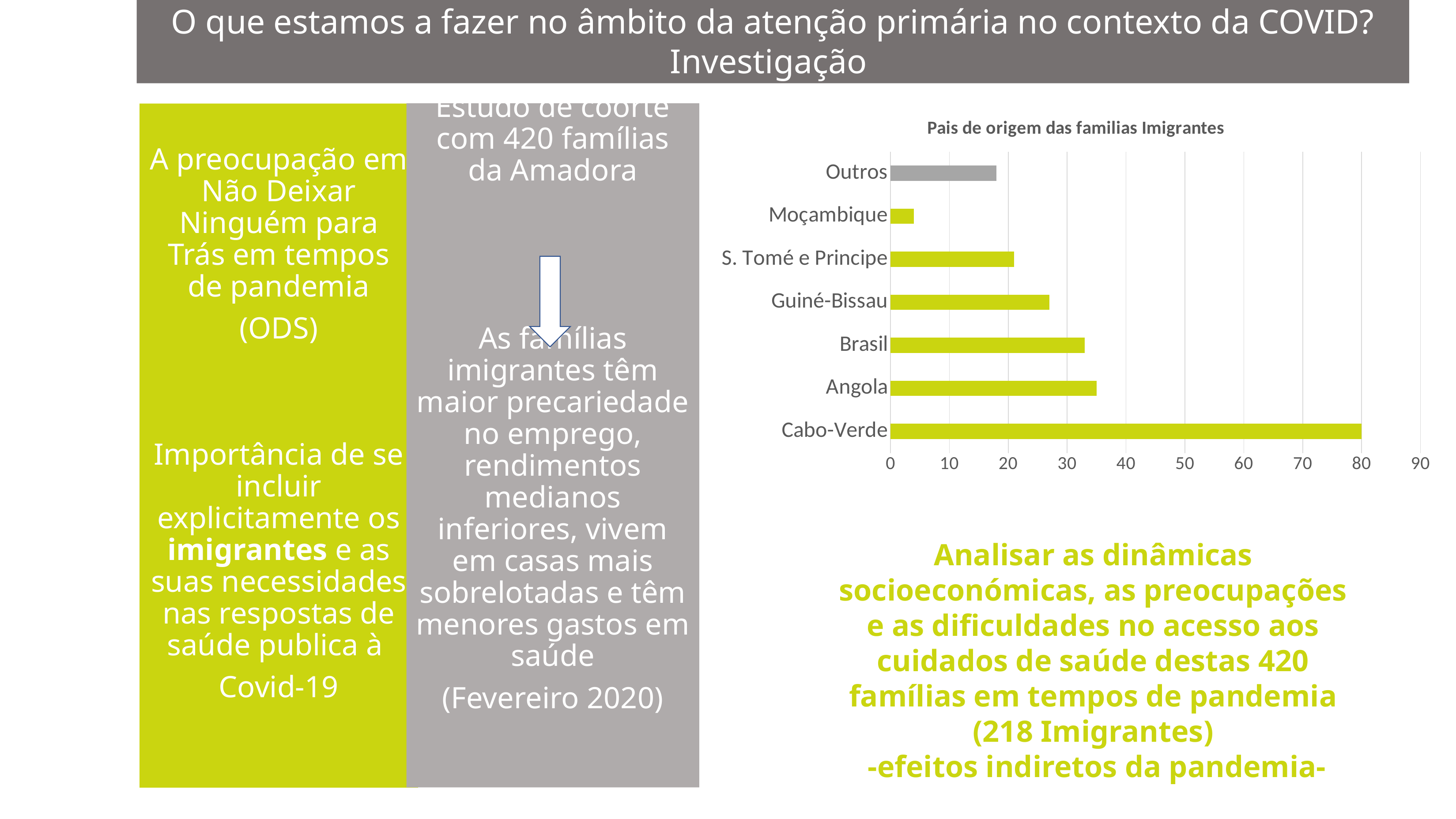
Which has a larger value, Brasil or Guiné-Bissau? Brasil Is the value for Outros greater or less than 20? less Is the value for Guiné-Bissau greater or less than 30? less Which bar in the chart is coloured grey rather than green? Outros What type of chart is shown on the slide? bar chart How many countries/categories are shown in the chart? 7 Is the value for Angola greater or less than 30? greater What is the title of the chart? Pais de origem das familias Imigrantes Which category has the highest value in the chart? Cabo-Verde What is the value for Cabo-Verde? 80 Which category has the lowest value in the chart? Moçambique